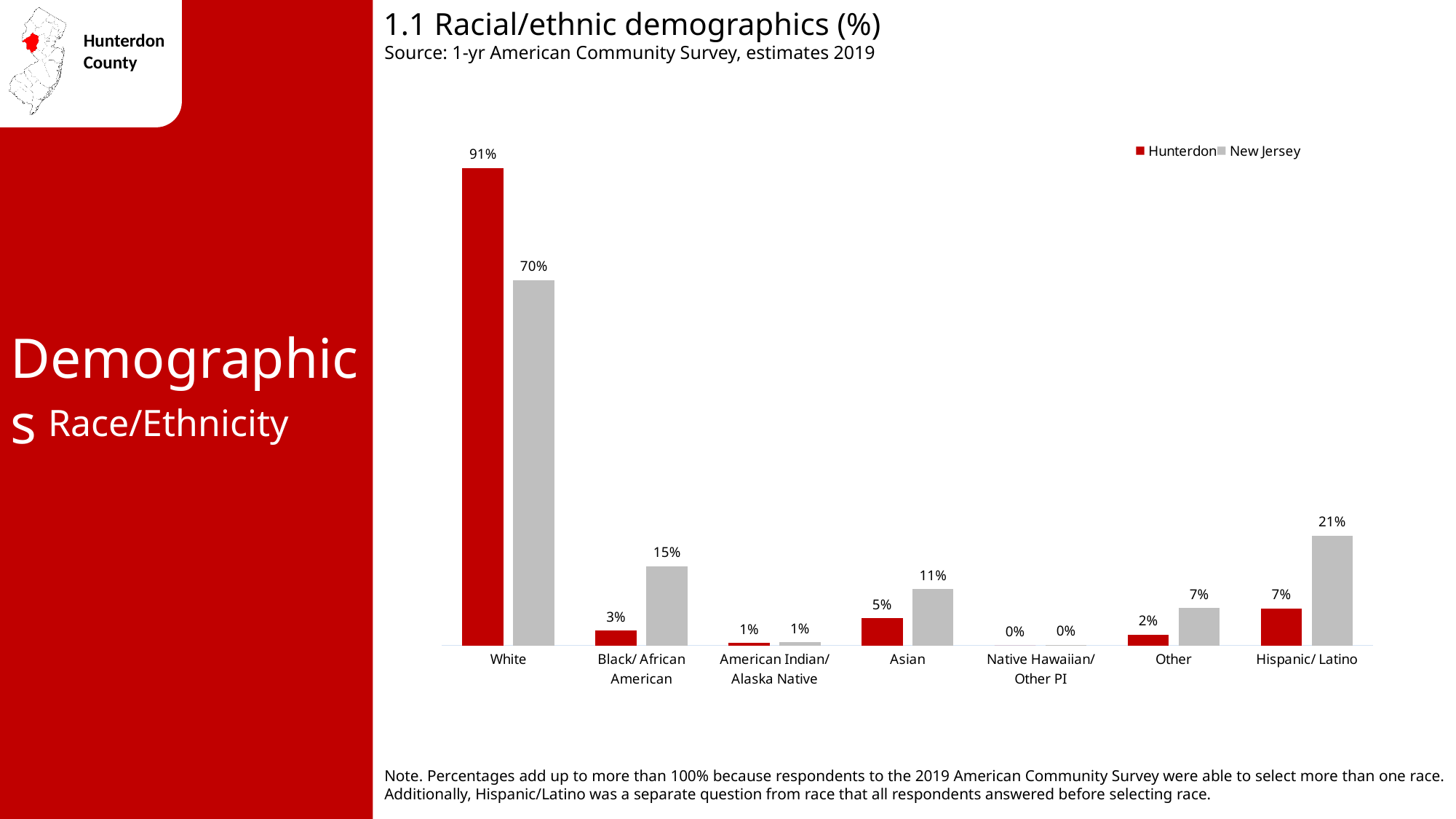
What is the Hunterdon value for White? 91% What is the difference between the Hunterdon and New Jersey values for White? 21% What is the Hunterdon value for Asian? 5% Which category has the highest Hunterdon value? White How many categories are shown on the x axis? 7 What is the New Jersey value for Hispanic/ Latino? 21% What is the difference between the New Jersey and Hunterdon values for Hispanic/ Latino? 14% What kind of chart is shown on the slide? Bar chart Which is larger for Asian, the Hunterdon value or the New Jersey value? New Jersey What is the New Jersey value for Black/ African American? 15% Which category has the lowest New Jersey value? Native Hawaiian/ Other PI How many series does the legend list? 2